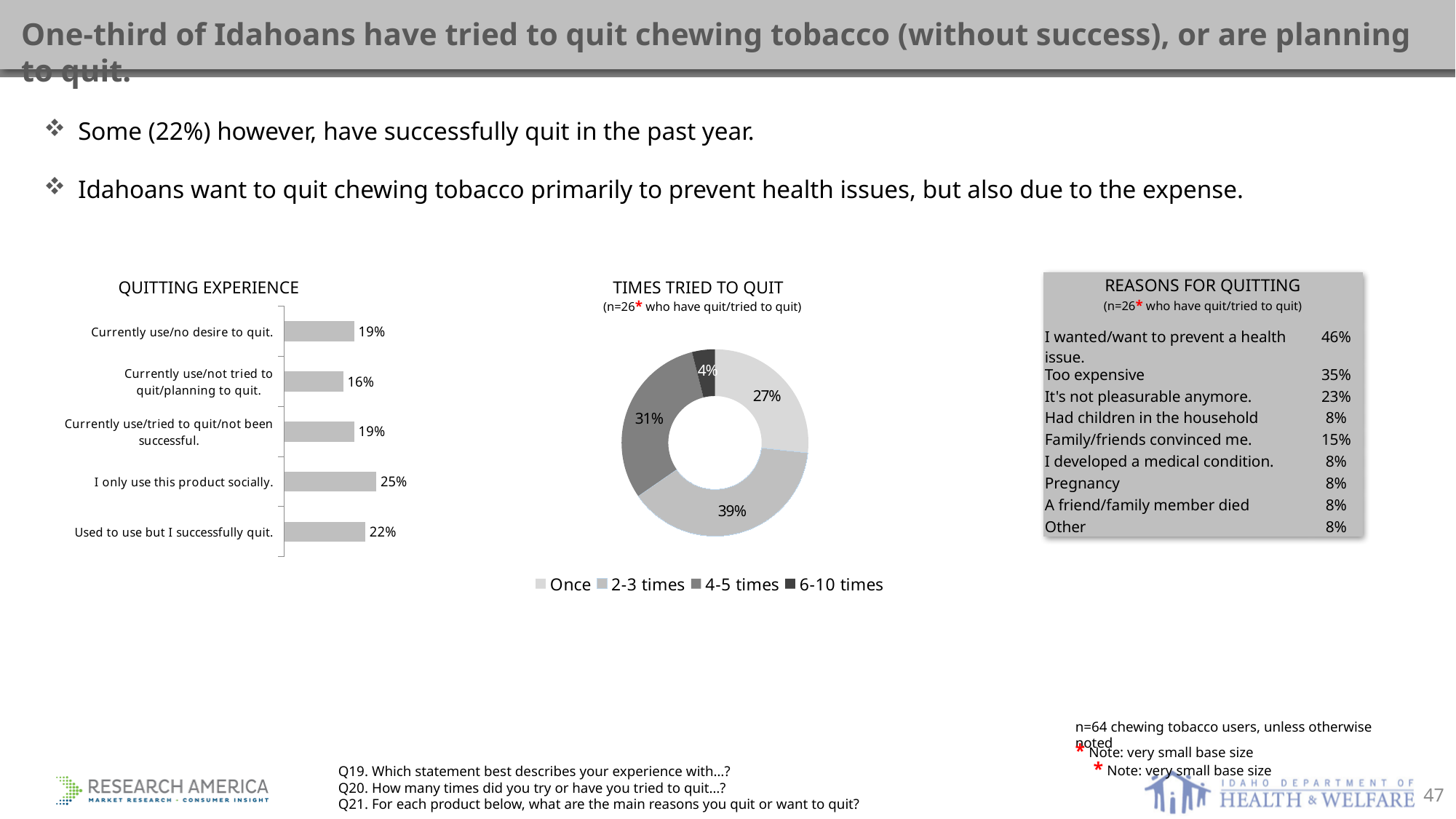
What type of chart is the QUITTING EXPERIENCE chart? Bar chart How many entries does the legend of the TIMES TRIED TO QUIT chart list? 4 In the TIMES TRIED TO QUIT chart, what is the value for 6-10 times? 4% What type of chart is the TIMES TRIED TO QUIT chart? Donut chart In the TIMES TRIED TO QUIT chart, what share of respondents tried to quit 2-3 times? 39% In the QUITTING EXPERIENCE chart, which category has the highest value? I only use this product socially. In the QUITTING EXPERIENCE chart, what percentage of respondents say they only use this product socially? 25% In the QUITTING EXPERIENCE chart, which category has the lowest value? Currently use/not tried to quit/planning to quit. In the TIMES TRIED TO QUIT chart, which is larger: Once or 4-5 times? 4-5 times In the QUITTING EXPERIENCE chart, what is the difference between "I only use this product socially" and "Currently use/not tried to quit/planning to quit"? 9 percentage points In the QUITTING EXPERIENCE chart, what is the value for "Used to use but I successfully quit"? 22% How many categories are shown in the QUITTING EXPERIENCE chart? 5